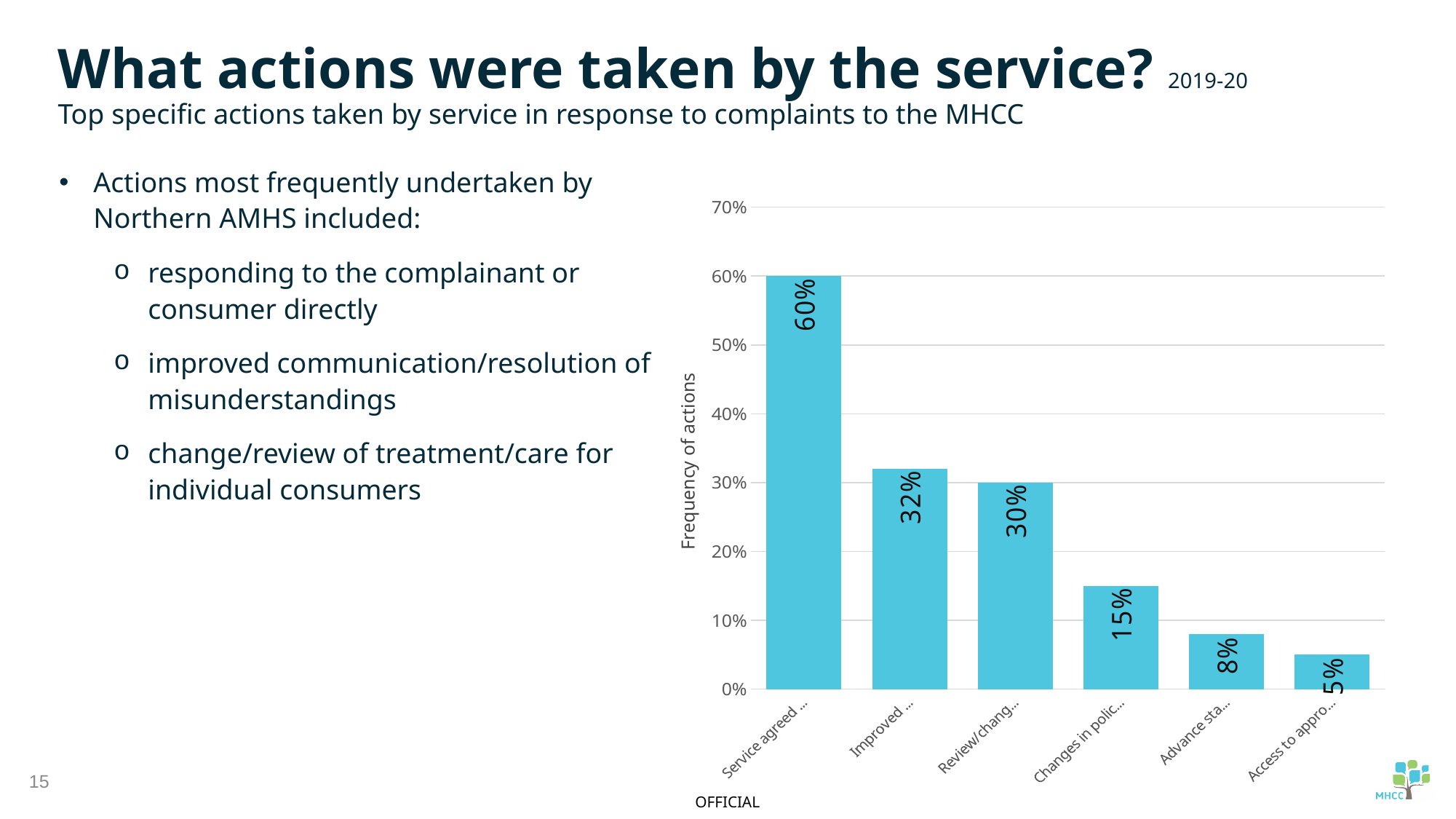
What is the value of the last bar, labelled "Access to appro..."? 5% How many bars are plotted in the chart? 6 What type of chart is shown on the slide? bar chart What is the label of the vertical axis? Frequency of actions What is the value of the bar labelled "Changes in polic..."? 15% What is the value of the bar labelled "Improved ..."? 32% What is the value of the bar labelled "Review/chang..."? 30% Which bar has the highest value? Service agreed ... What is the value of the first bar, labelled "Service agreed ..."? 60% Do the bar values rise or fall from left to right along the x axis? fall What is the difference between the values of the "Service agreed ..." bar and the "Improved ..." bar? 28% Which bar has the lowest value? Access to appro...